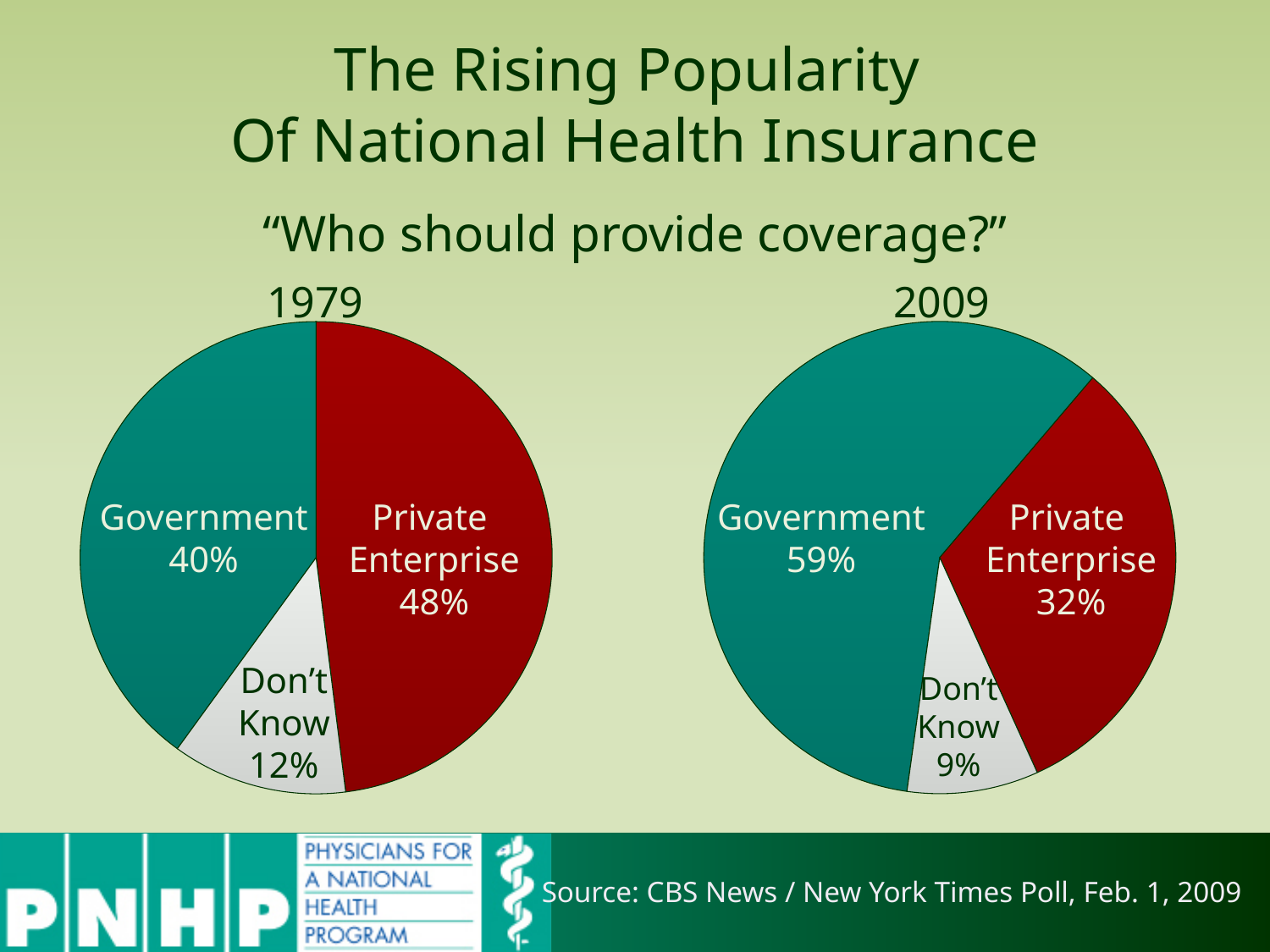
How many slices does the 2009 pie chart have? 3 In the 1979 pie chart, which category has the largest share? Private Enterprise In the 1979 pie chart, what is the difference between Private Enterprise and Don't Know? 36 percentage points What is the difference between the Government share in 2009 and the Government share in 1979? 19 percentage points In the 2009 pie chart, what share of respondents said Private Enterprise should provide coverage? 32% In the 2009 pie chart, which category has the smallest share? Don't Know In the 2009 pie chart, what is the value for Don't Know? 9% In the 1979 pie chart, what share of respondents said Government should provide coverage? 40% Which is larger: the Private Enterprise share in 1979 or the Private Enterprise share in 2009? 1979 How many pie charts are shown on the slide? 2 What type of chart is used to show the 1979 data? Pie chart What colour is the Government slice in both pie charts? Teal